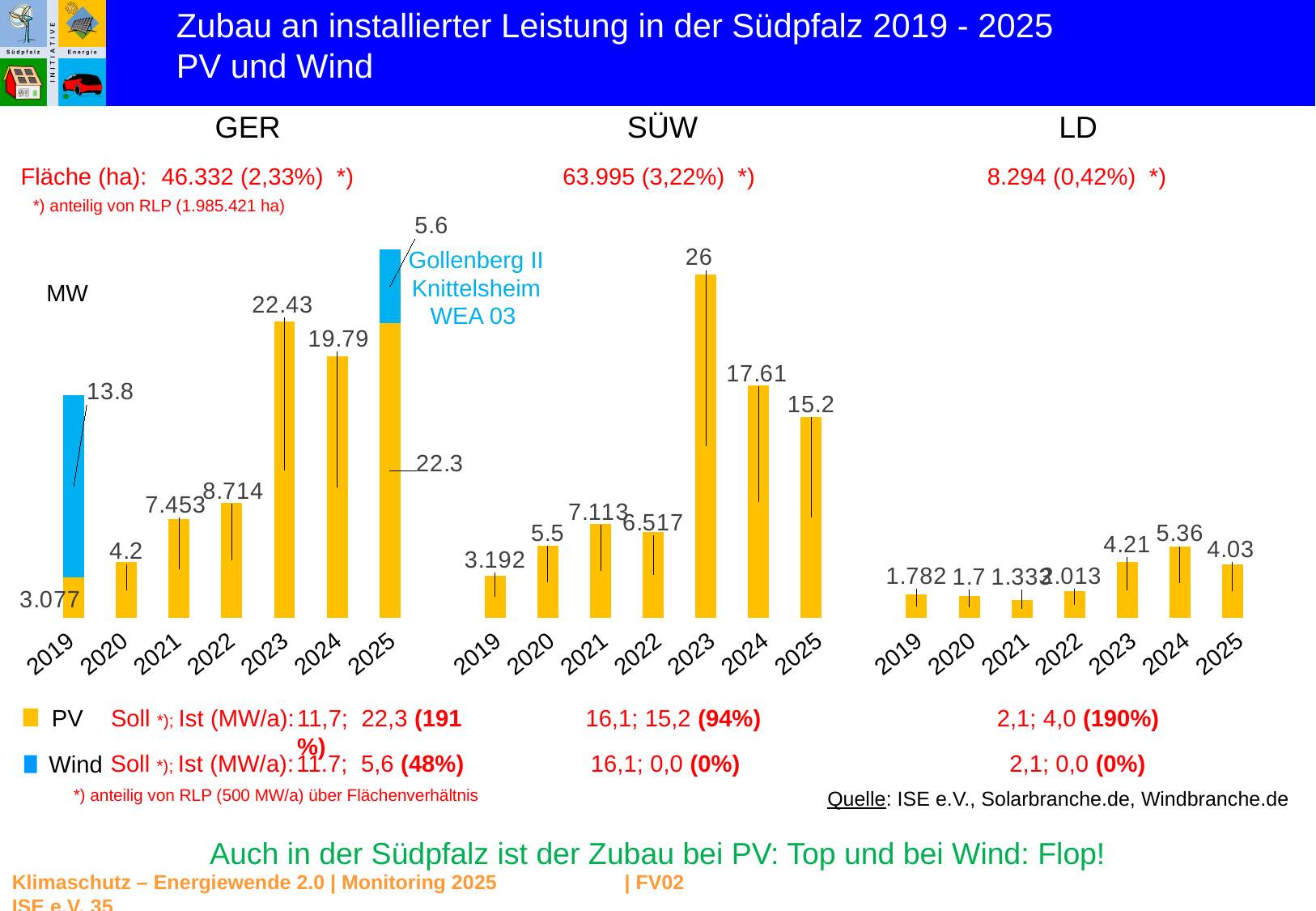
What kind of chart is the LD chart? bar chart In the LD chart, which year has the lowest value? 2021 In the SÜW chart, what is the difference between the values for 2024 and 2025? 2.41 In the GER chart, what is the Wind value for 2019? 13.8 In the LD chart, what is the value for 2024? 5.36 In the GER chart, what is the PV value for 2023? 22.43 In the SÜW chart, what is the value for 2023? 26 How many series does the legend list? 2 In the SÜW chart, which year has the highest value? 2023 In the GER chart, what is the total of the stacked bar for 2025 (PV plus Wind)? 27.9 How many years are shown on the x axis of the SÜW chart? 7 In the LD chart, which is larger, the value for 2023 or the value for 2025? 2023